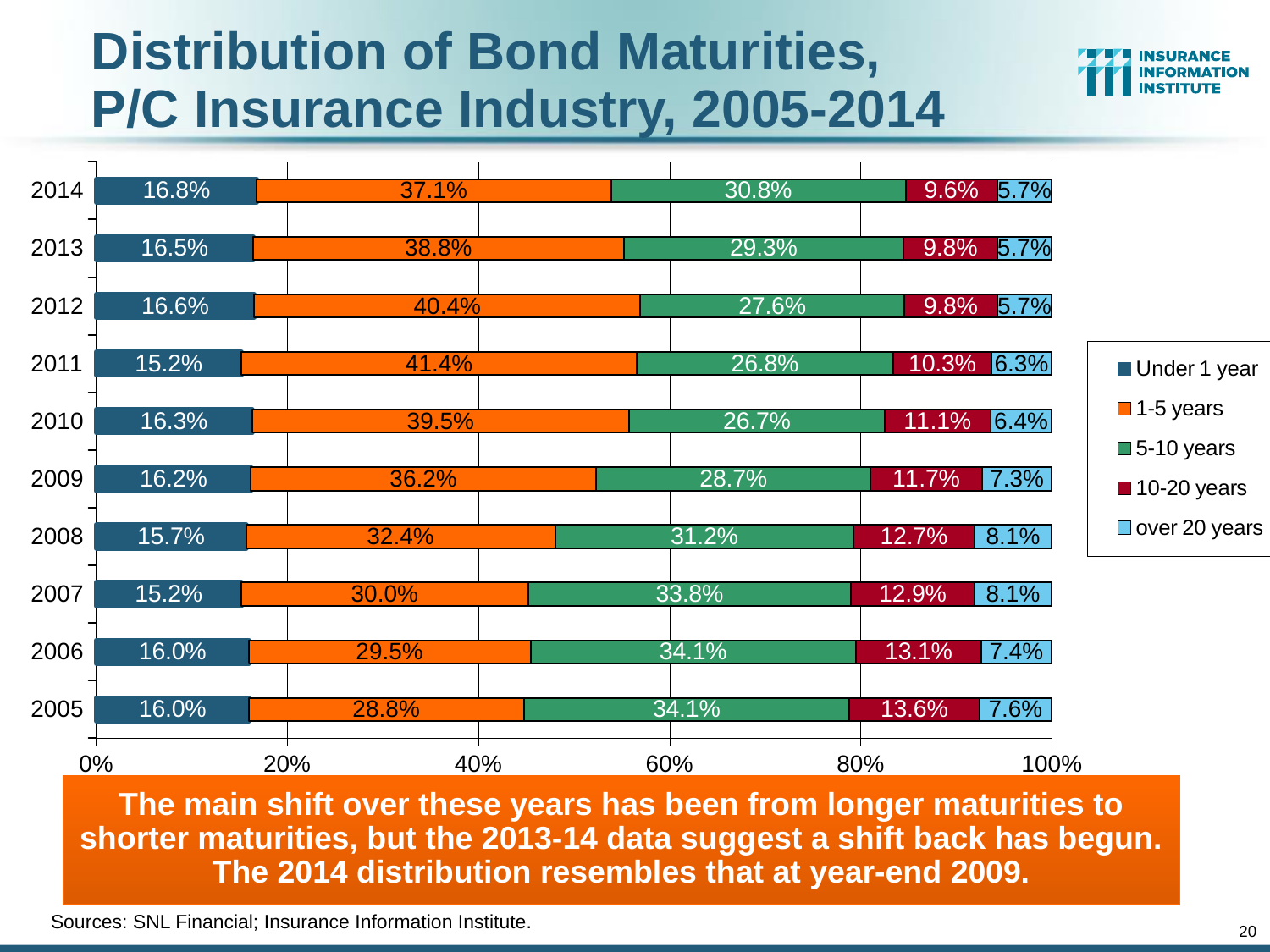
What is the difference between the 1-5 years share in 2014 and in 2005? 8.3 percentage points What share of bonds had a 10-20 years maturity in 2008? 12.7% In which year was the over 20 years share the lowest? 2012, 2013 and 2014 (5.7%) Which is larger: the 5-10 years share in 2007 or in 2014? 2007 Which maturity bucket is shown in orange in the legend? 1-5 years What share of bonds had a 1-5 years maturity in 2014? 37.1% How many years are shown on the chart? 10 What kind of chart is this? Stacked bar chart What share of bonds had a 5-10 years maturity in 2005? 34.1% In which year was the 1-5 years share the highest? 2011 What share of bonds had an over 20 years maturity in 2011? 6.3% How many series does the legend list? 5